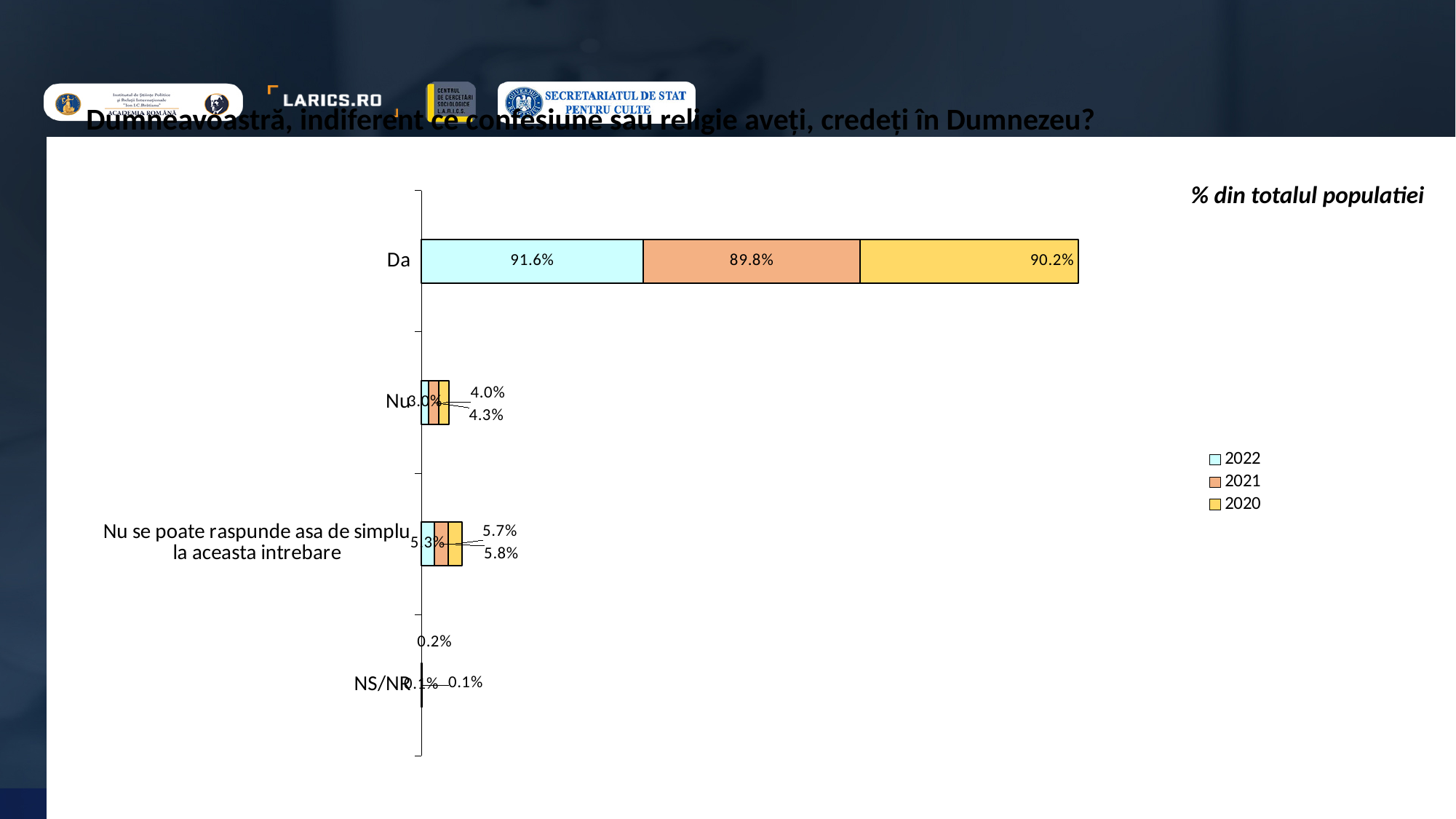
Which year has the lowest value for "Nu"? 2022 What is the difference between the 2022 and 2021 values for "Da"? 1.8% Which is larger for "Nu": the 2021 value or the 2020 value? 2021 What type of chart is shown on the slide? Bar chart What percentage answered "Da" in 2022? 91.6% How many answer categories are shown on the chart? 4 What is the value for "Nu se poate raspunde asa de simplu la aceasta intrebare" in 2022? 5.3% How many series does the legend list? 3 What is the value for "Nu" in 2020? 4.0% What percentage answered "Da" in 2021? 89.8% What percentage answered "Da" in 2020? 90.2% Which year has the highest value for "Da"? 2022